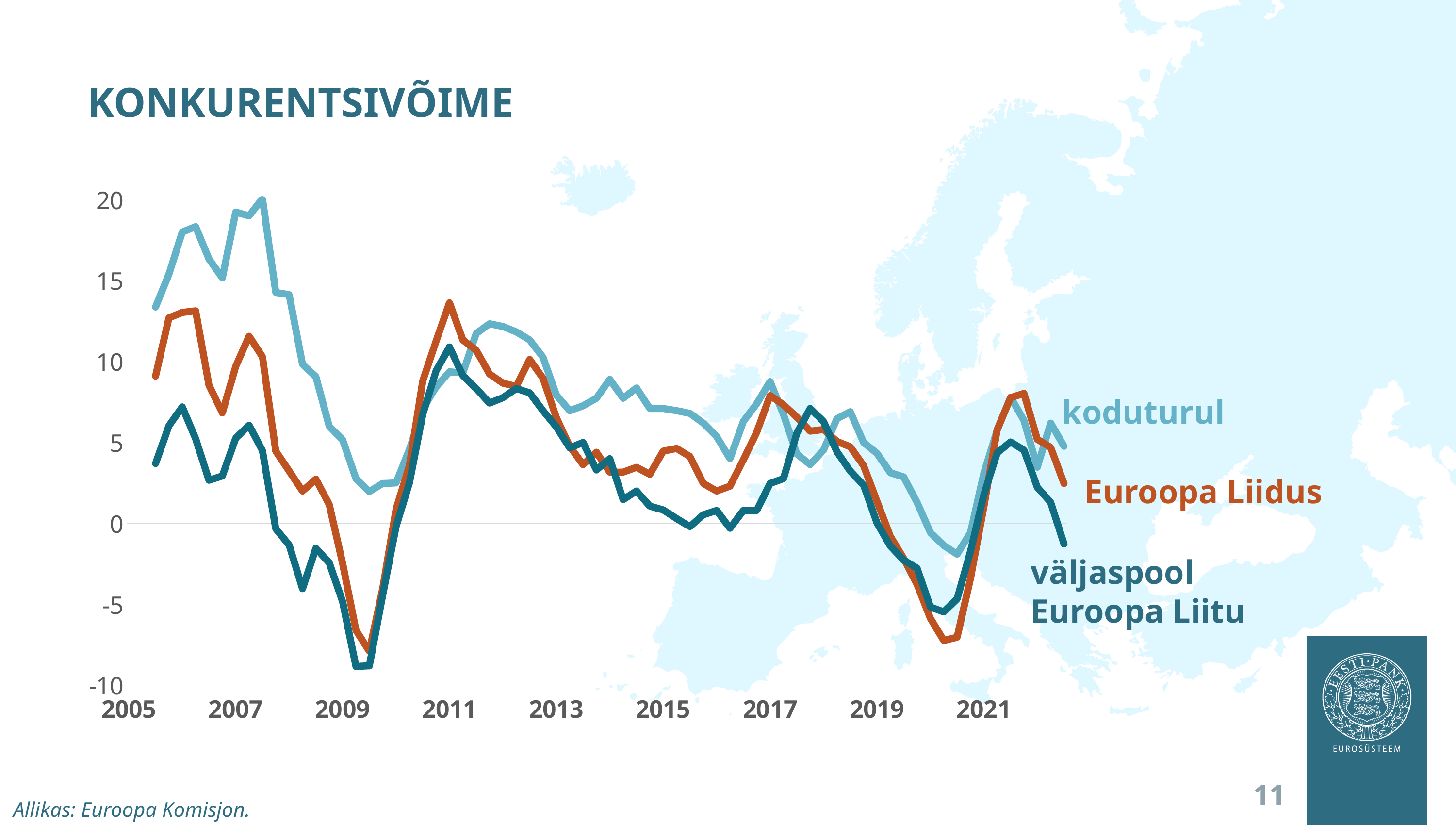
Is the value of the väljaspool Euroopa Liitu series at the start of 2005 greater or less than 5? less Is the peak value of the koduturul series around 2007 greater or less than 15? greater What kind of chart is shown on the slide? line chart Is the value of the Euroopa Liidus series at the start of 2005 greater or less than 10? less At the start of 2005, which series has the higher value: koduturul or väljaspool Euroopa Liitu? koduturul How many series are plotted on the chart? 3 Which series reaches the highest value anywhere on the chart? koduturul Does the Euroopa Liidus series rise or fall between 2011 and 2013? fall What is the title of the chart on the slide? KONKURENTSIVÕIME Which series is drawn in orange? Euroopa Liidus Does the koduturul series rise or fall between 2005 and 2007? rise